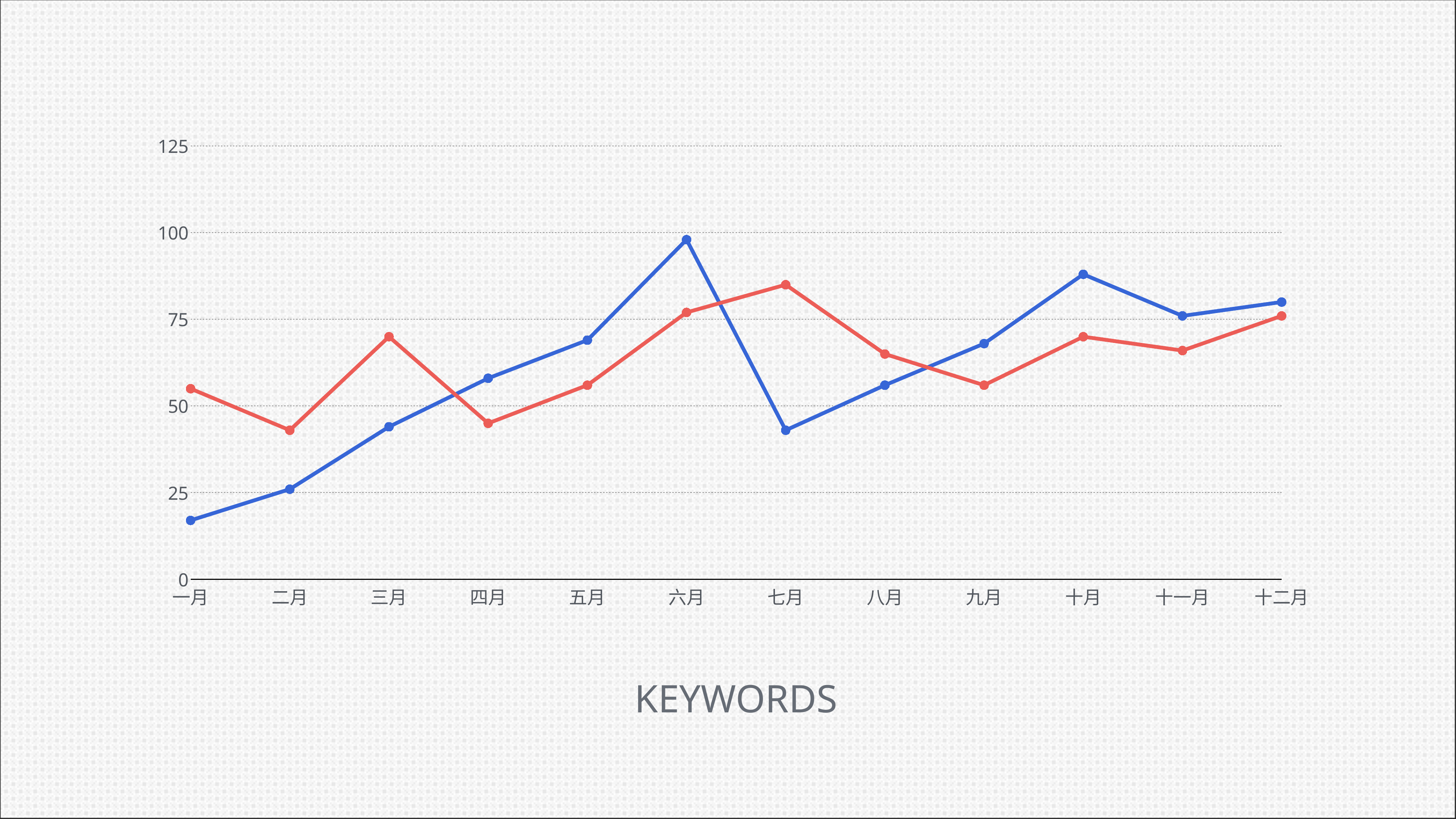
What title is shown below the chart? KEYWORDS Is the value of the blue line for 六月 greater or less than 75? greater What kind of chart is shown on the slide? line chart Is the value of the blue line for 一月 greater or less than 25? less How many months are plotted along the x axis? 12 In which month does the blue line have its lowest value? 一月 How many lines are plotted on the chart? 2 In 七月, which line has the larger value, the blue line or the red line? the red line Is the value of the red line for 七月 greater or less than 75? greater In which month does the red line reach its highest value? 七月 Does the blue line rise or fall from 一月 to 六月? rise In which month does the blue line reach its highest value? 六月